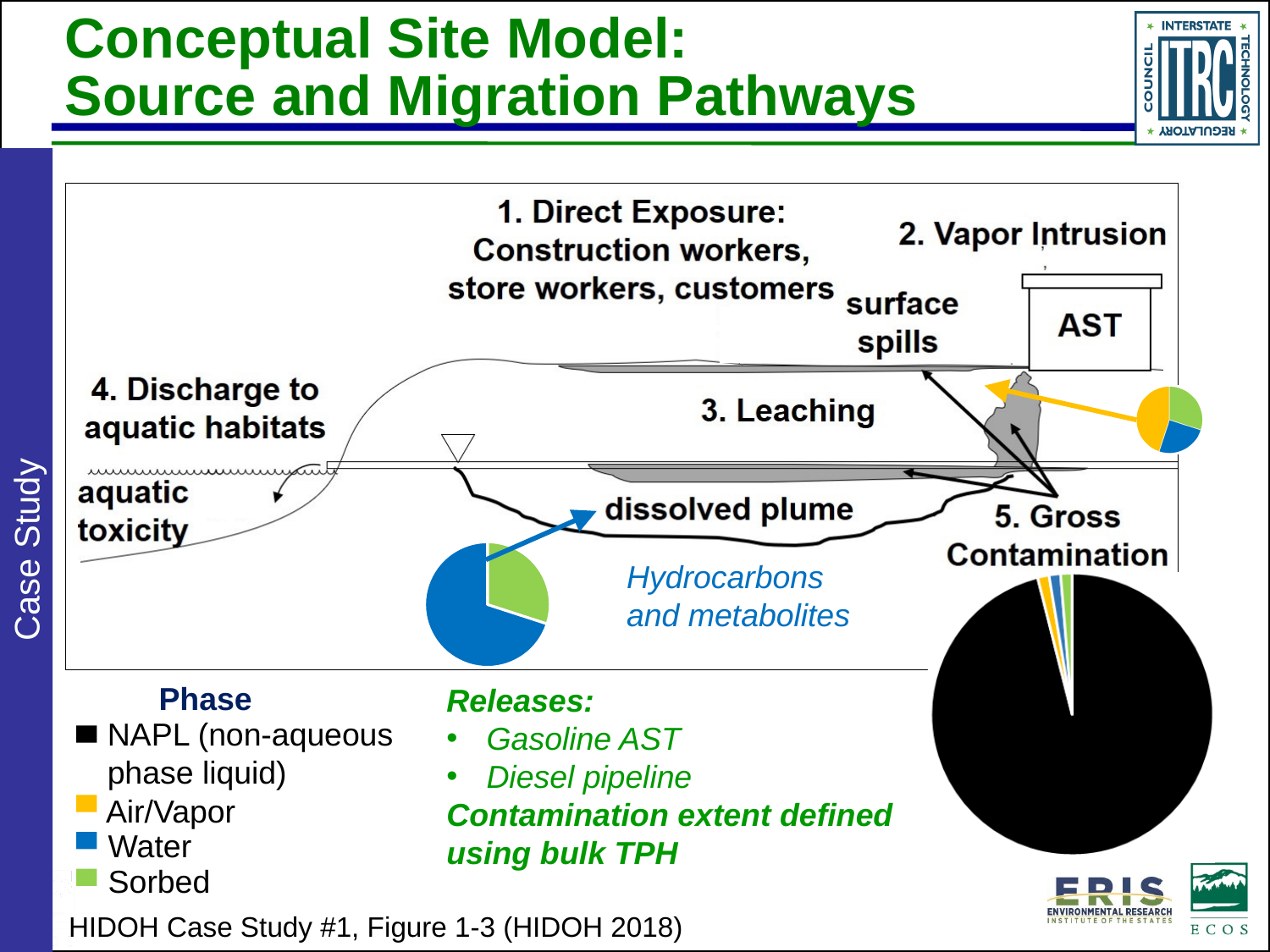
In the pie chart below the dissolved plume, which is larger, the Water slice or the Sorbed slice? Water In the small pie chart next to the AST, which phase has the largest slice? Air/Vapor In the pie chart below the dissolved plume, which two phases are shown? Water and Sorbed How many phases does the Phase legend list? 4 How many pie charts are shown on the slide? 3 In the pie chart below the dissolved plume, which phase has the largest slice? Water Which colour represents Water in the Phase legend? Blue What kind of charts are shown on the slide? Pie charts In the large pie chart at the bottom right (Gross Contamination), which phase has the largest slice? NAPL (non-aqueous phase liquid) Which phase is shown in black in the pie charts? NAPL (non-aqueous phase liquid)